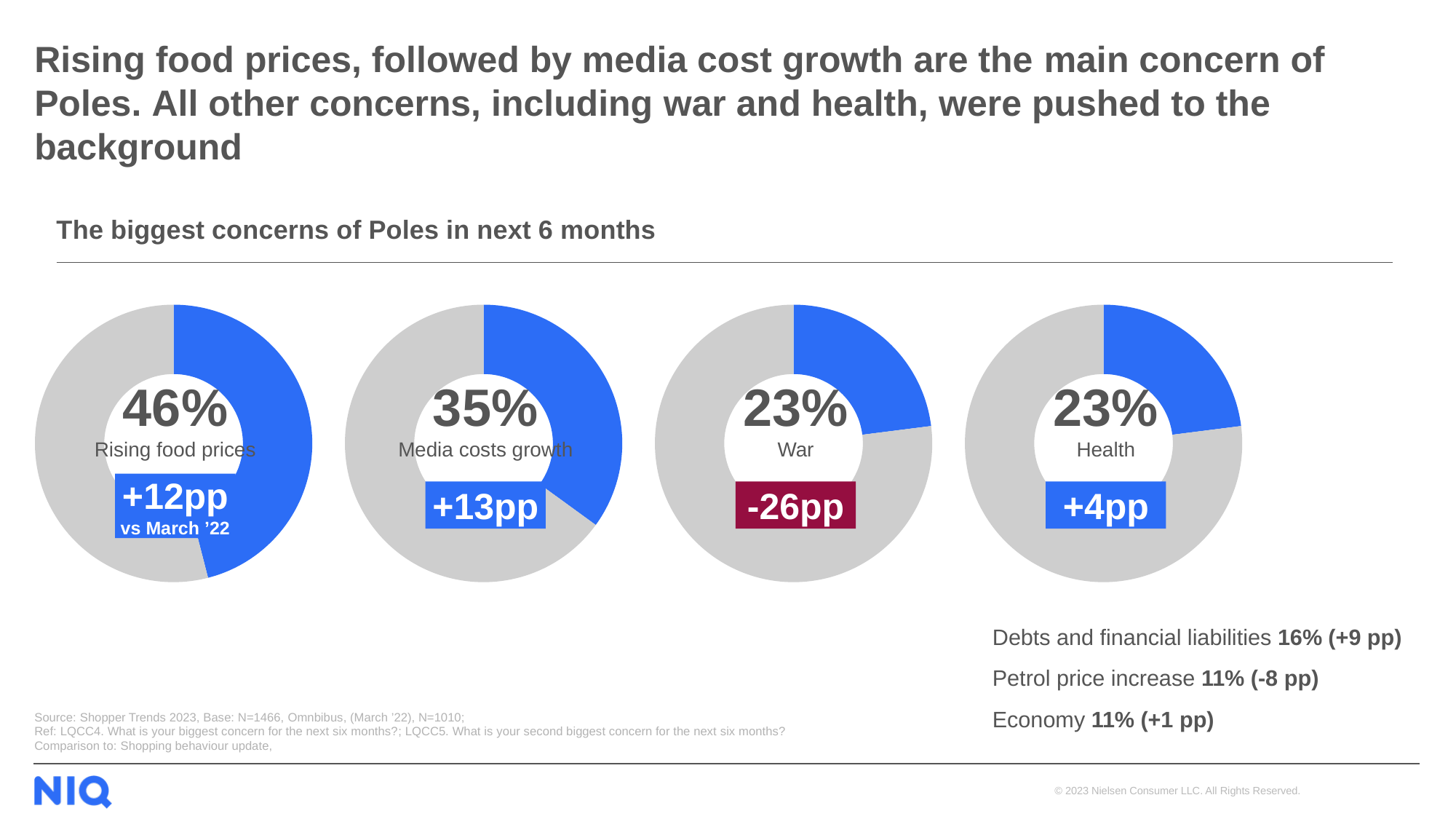
What is the change versus March '22 shown for health? +4pp What percentage is shown for war? 23% What kind of chart is used to show the biggest concerns of Poles? Donut (pie) chart Which concern has the highest percentage among the four donut charts? Rising food prices What percentage is shown for media costs growth? 35% What percentage of Poles name rising food prices as a concern in the next 6 months? 46% What is the change versus March '22 shown for war? -26pp What is the change versus March '22 shown for media costs growth? +13pp What is the difference in percentage points between rising food prices and media costs growth? 11 percentage points Which is larger, the percentage for media costs growth or the percentage for health? Media costs growth How many donut charts are shown on the slide? 4 Which concern's change versus March '22 is shown in a dark red box instead of blue? War